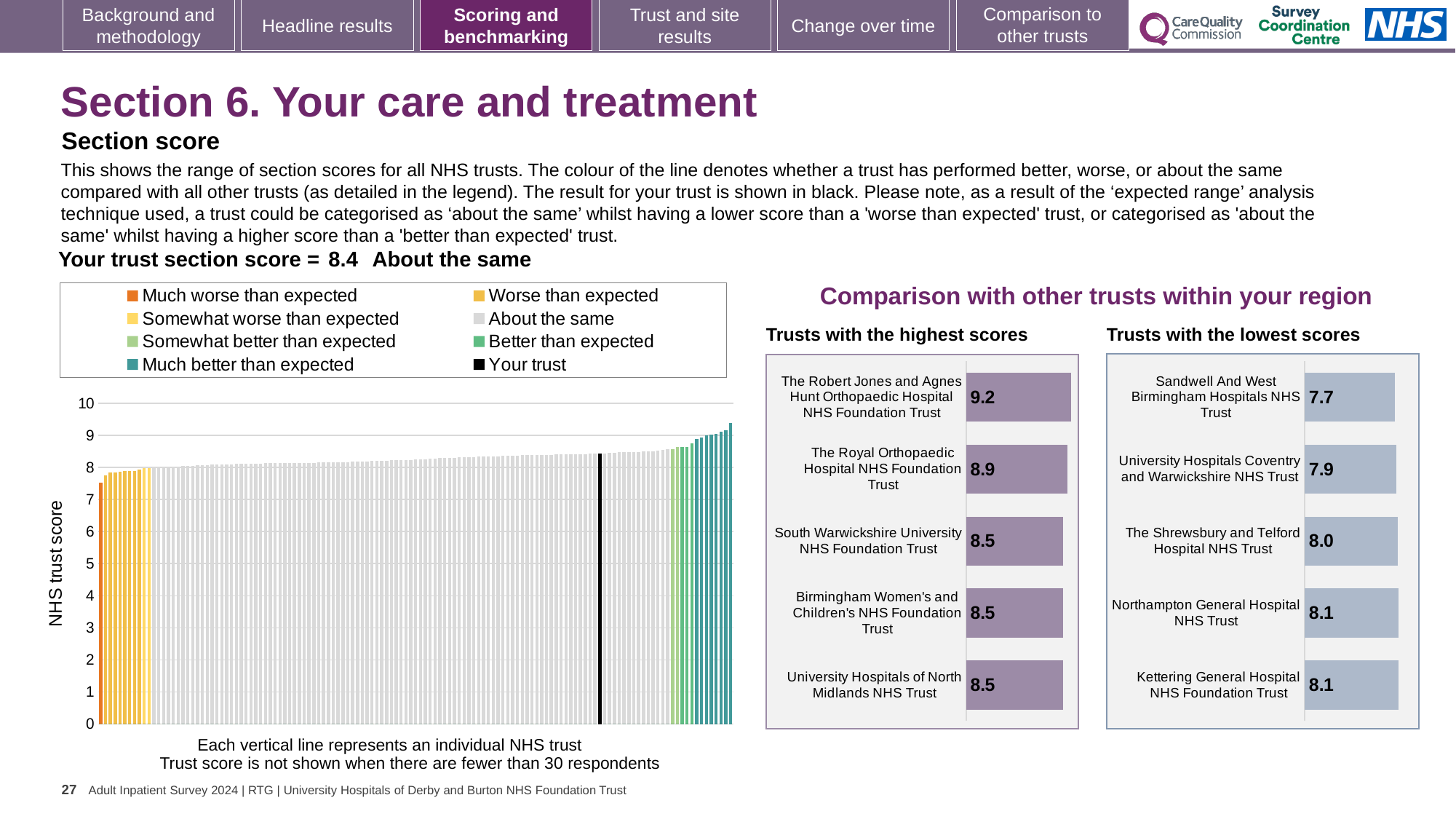
On the 'Trusts with the highest scores' chart, which trust has the highest score? The Robert Jones and Agnes Hunt Orthopaedic Hospital NHS Foundation Trust On the 'Trusts with the highest scores' chart, what is the score for The Royal Orthopaedic Hospital NHS Foundation Trust? 8.9 On the 'Trusts with the lowest scores' chart, which has the larger score: University Hospitals Coventry and Warwickshire NHS Trust or The Shrewsbury and Telford Hospital NHS Trust? The Shrewsbury and Telford Hospital NHS Trust On the 'Trusts with the lowest scores' chart, how many trusts are shown? 5 What kind of chart is the main chart of NHS trust scores? bar chart On the main chart of NHS trust scores, do the values rise or fall from left to right? rise On the main chart of NHS trust scores, is the value of the leftmost (orange) bar greater or less than 8? less On the 'Trusts with the highest scores' chart, what is the difference between the scores of The Robert Jones and Agnes Hunt Orthopaedic Hospital NHS Foundation Trust and The Royal Orthopaedic Hospital NHS Foundation Trust? 0.3 On the main chart of NHS trust scores, how many entries does the legend list? 8 On the main chart of NHS trust scores, what is the section score for your trust? 8.4 On the 'Trusts with the lowest scores' chart, which trust has the lowest score? Sandwell And West Birmingham Hospitals NHS Trust On the main chart of NHS trust scores, is the value of the rightmost bar greater or less than 9? greater